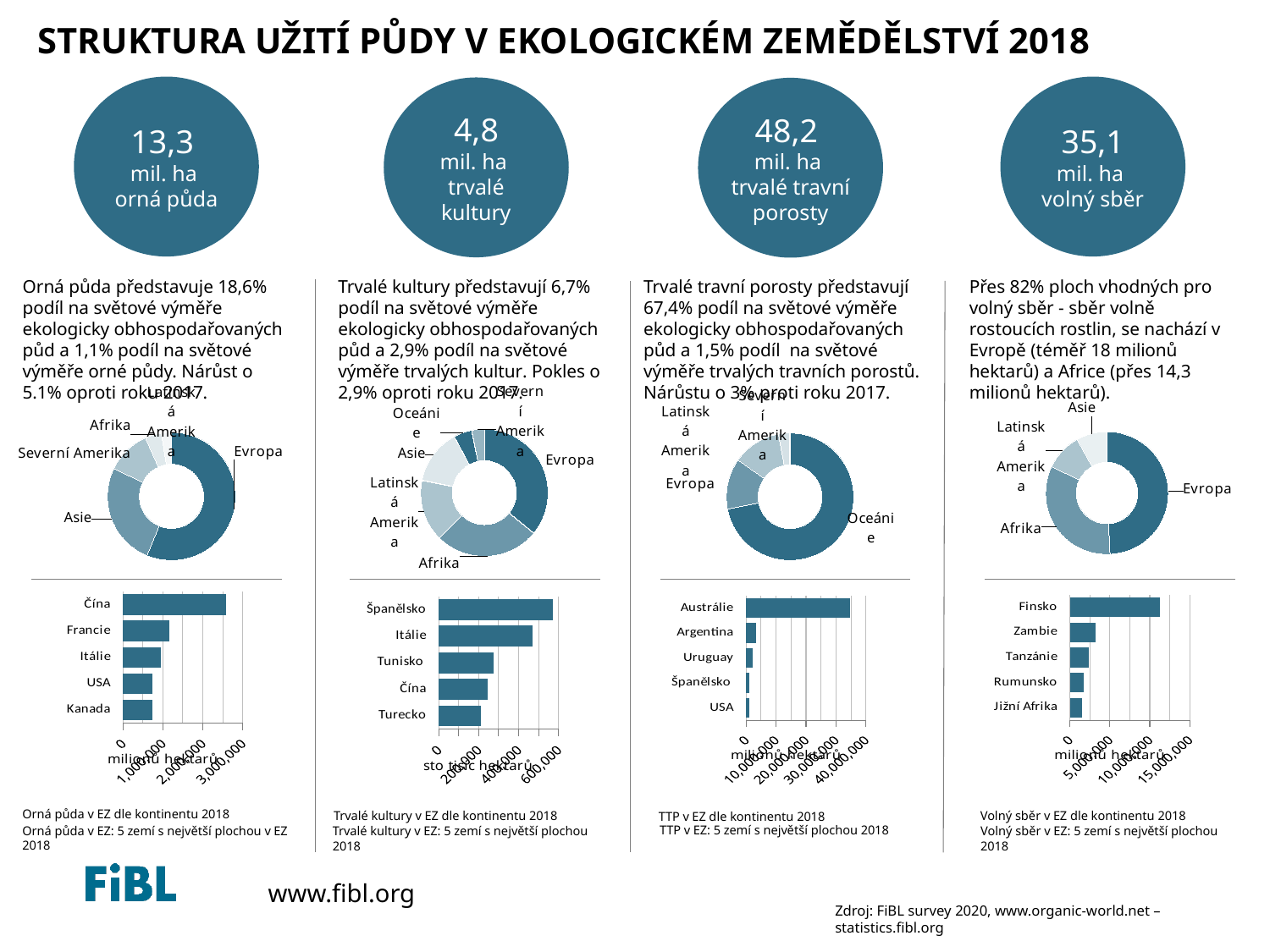
In the chart 'Volný sběr v EZ dle kontinentu 2018', which continent has the largest share? Evropa In the chart 'Trvalé kultury v EZ: 5 zemí s největší plochou 2018', which country has the largest area? Španělsko In the chart 'TTP v EZ: 5 zemí s největší plochou 2018', which country has the largest area? Austrálie In the chart 'Orná půda v EZ: 5 zemí s největší plochou v EZ 2018', is the value for Čína greater or less than 2,000,000? greater In the chart 'TTP v EZ: 5 zemí s největší plochou 2018', is the value for Austrálie greater or less than 30,000,000? greater In the chart 'Orná půda v EZ: 5 zemí s největší plochou v EZ 2018', is the value for Francie greater or less than 2,000,000? less How many countries are shown in the chart 'Trvalé kultury v EZ: 5 zemí s největší plochou 2018'? 5 In the chart 'Trvalé kultury v EZ: 5 zemí s největší plochou 2018', which is larger, Itálie or Tunisko? Itálie In the chart 'Volný sběr v EZ: 5 zemí s největší plochou 2018', which is larger, Zambie or Jižní Afrika? Zambie What kind of chart is 'Orná půda v EZ dle kontinentu 2018'? Donut chart